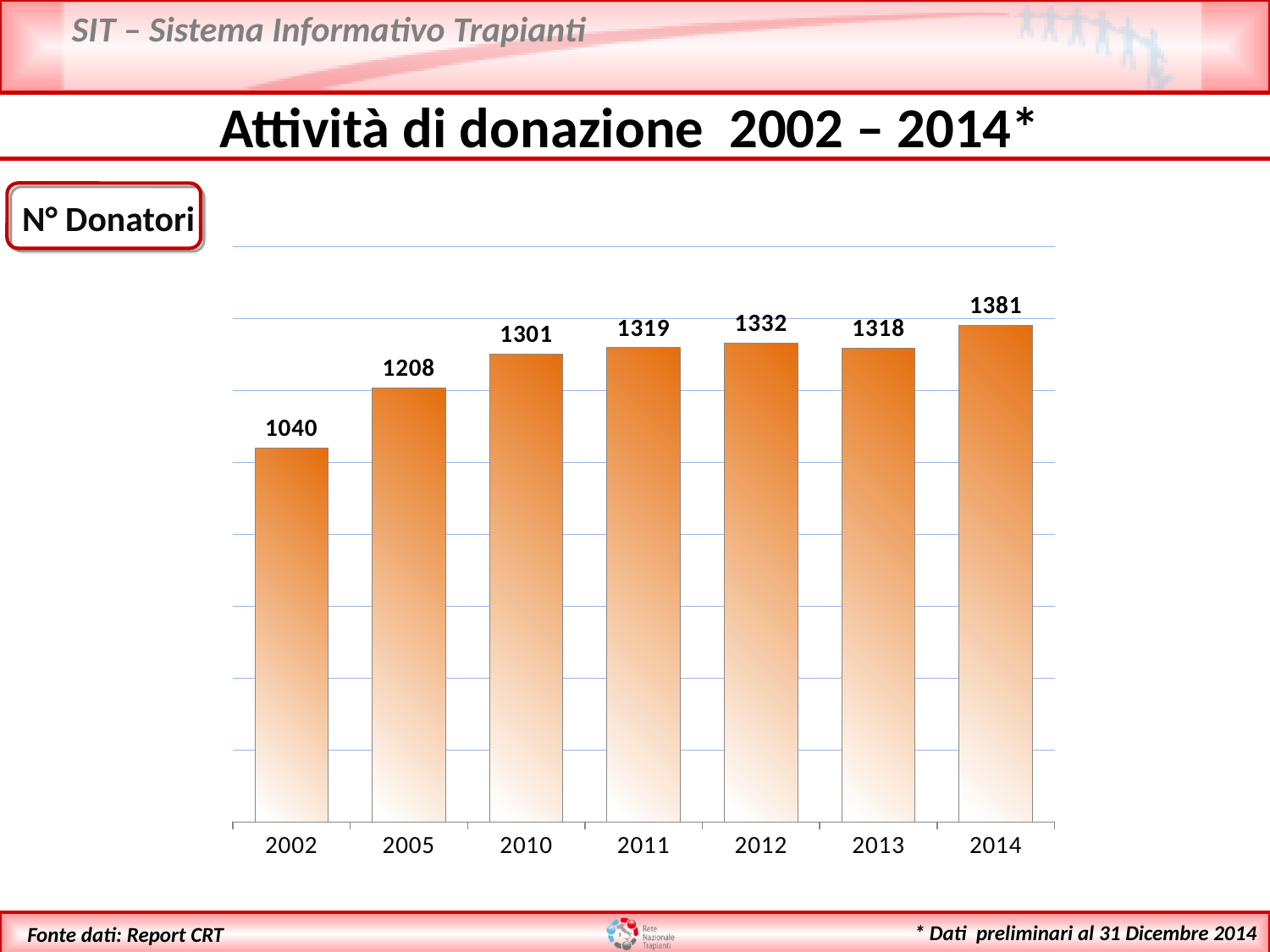
What value is shown for 2012? 1332 What is the number of donors (N° Donatori) shown for 2002? 1040 What kind of chart is shown on the slide? bar chart What is the difference between the values for 2005 and 2002? 168 Which is larger, the value for 2010 or the value for 2005? 2010 What is the difference between the values for 2014 and 2002? 341 What value is shown for 2014? 1381 Which year has the highest number of donors? 2014 What is the title of the slide containing the chart? Attività di donazione 2002 – 2014* Which year has the lowest number of donors? 2002 Which is larger, the value for 2012 or the value for 2013? 2012 How many years are shown on the x axis? 7